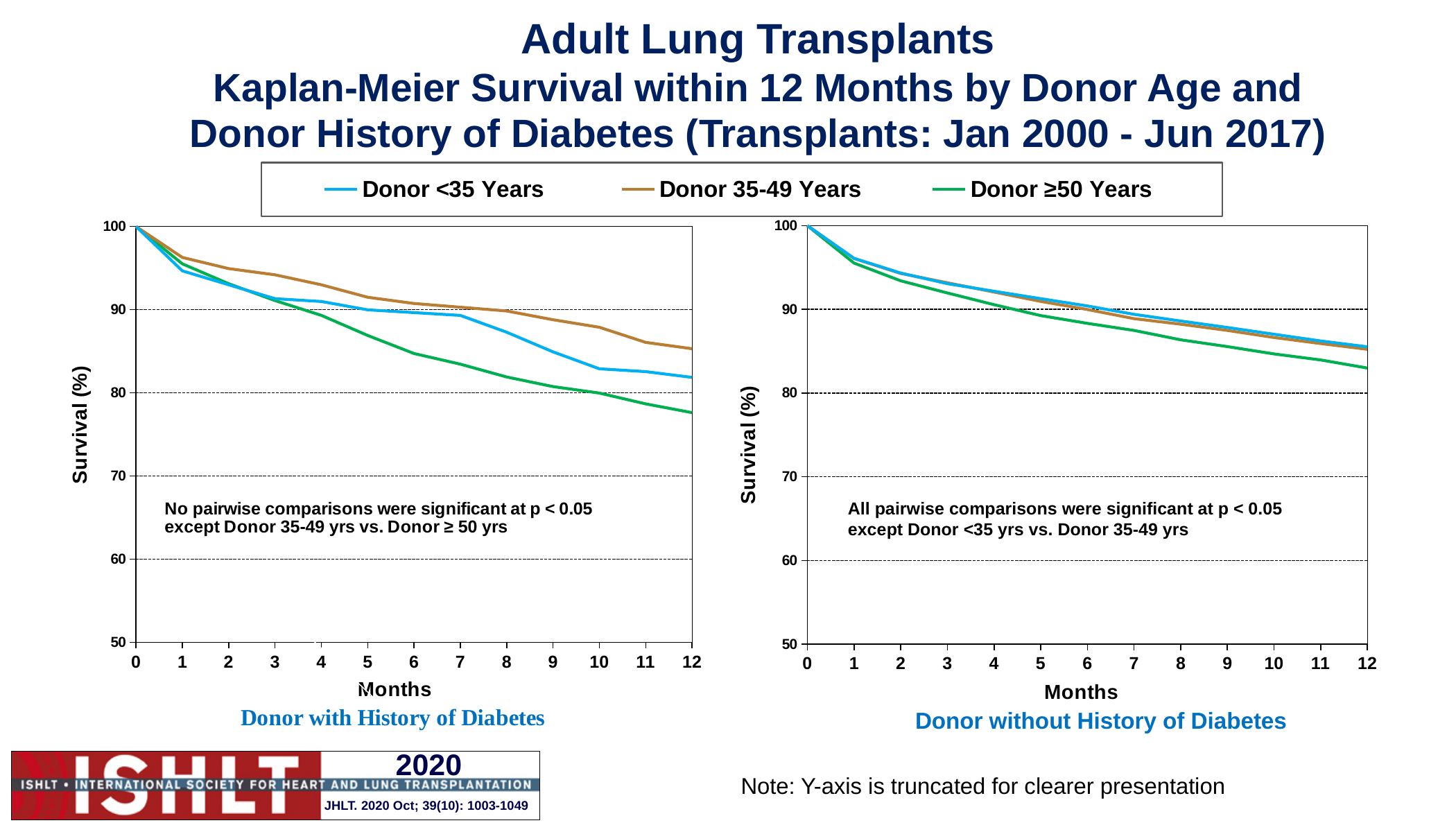
In the Donor without History of Diabetes chart, which is higher at 12 months: Donor <35 Years or Donor ≥50 Years? Donor <35 Years Which colour represents Donor ≥50 Years in the legend? Green How many series does the legend list? 3 In the Donor with History of Diabetes chart, which series has the highest survival at 12 months? Donor 35-49 Years In the Donor without History of Diabetes chart, is the survival for Donor ≥50 Years at 12 months greater or less than 90? less What type of chart is used on the slide for the Donor with History of Diabetes panel? Line chart In the Donor with History of Diabetes chart, is the survival for Donor 35-49 Years at 12 months greater or less than 80? greater In the Donor with History of Diabetes chart, which series has the lowest survival at 12 months? Donor ≥50 Years In the Donor without History of Diabetes chart, does survival rise or fall as months increase? Fall In the Donor without History of Diabetes chart, is the survival for Donor <35 Years at 1 month greater or less than 90? greater What is the survival value for all series at month 0 in the Donor with History of Diabetes chart? 100